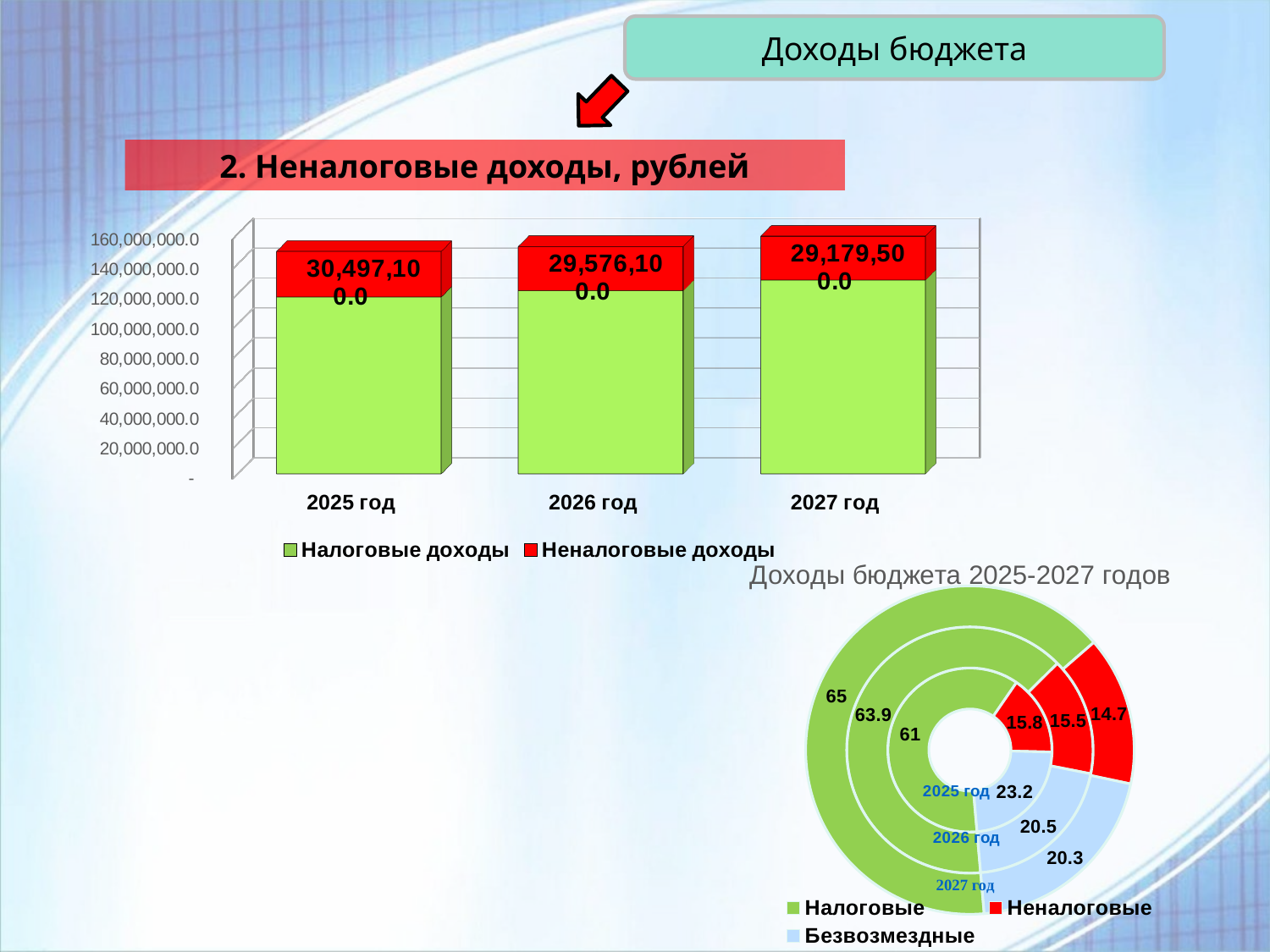
In the doughnut chart 'Доходы бюджета 2025-2027 годов', what is the value for Налоговые in 2027 год? 65 In the doughnut chart 'Доходы бюджета 2025-2027 годов', what is the value for Неналоговые in 2025 год? 15.8 In the bar chart '2. Неналоговые доходы, рублей', what is the value of Неналоговые доходы for 2027 год? 29,179,500.0 In the bar chart '2. Неналоговые доходы, рублей', which year has the highest Неналоговые доходы? 2025 год In the doughnut chart 'Доходы бюджета 2025-2027 годов', what is the value for Безвозмездные in 2026 год? 20.5 What kind of chart is '2. Неналоговые доходы, рублей'? bar chart In the bar chart '2. Неналоговые доходы, рублей', how many years are shown on the x axis? 3 In the bar chart '2. Неналоговые доходы, рублей', how many series does the legend list? 2 In the bar chart '2. Неналоговые доходы, рублей', do the Неналоговые доходы values rise or fall from 2025 год to 2027 год? fall In the bar chart '2. Неналоговые доходы, рублей', what is the difference between Неналоговые доходы in 2025 год and 2027 год? 1,317,600.0 In the bar chart '2. Неналоговые доходы, рублей', what is the value of Неналоговые доходы for 2025 год? 30,497,100.0 In the doughnut chart 'Доходы бюджета 2025-2027 годов', how many categories does the legend list? 3